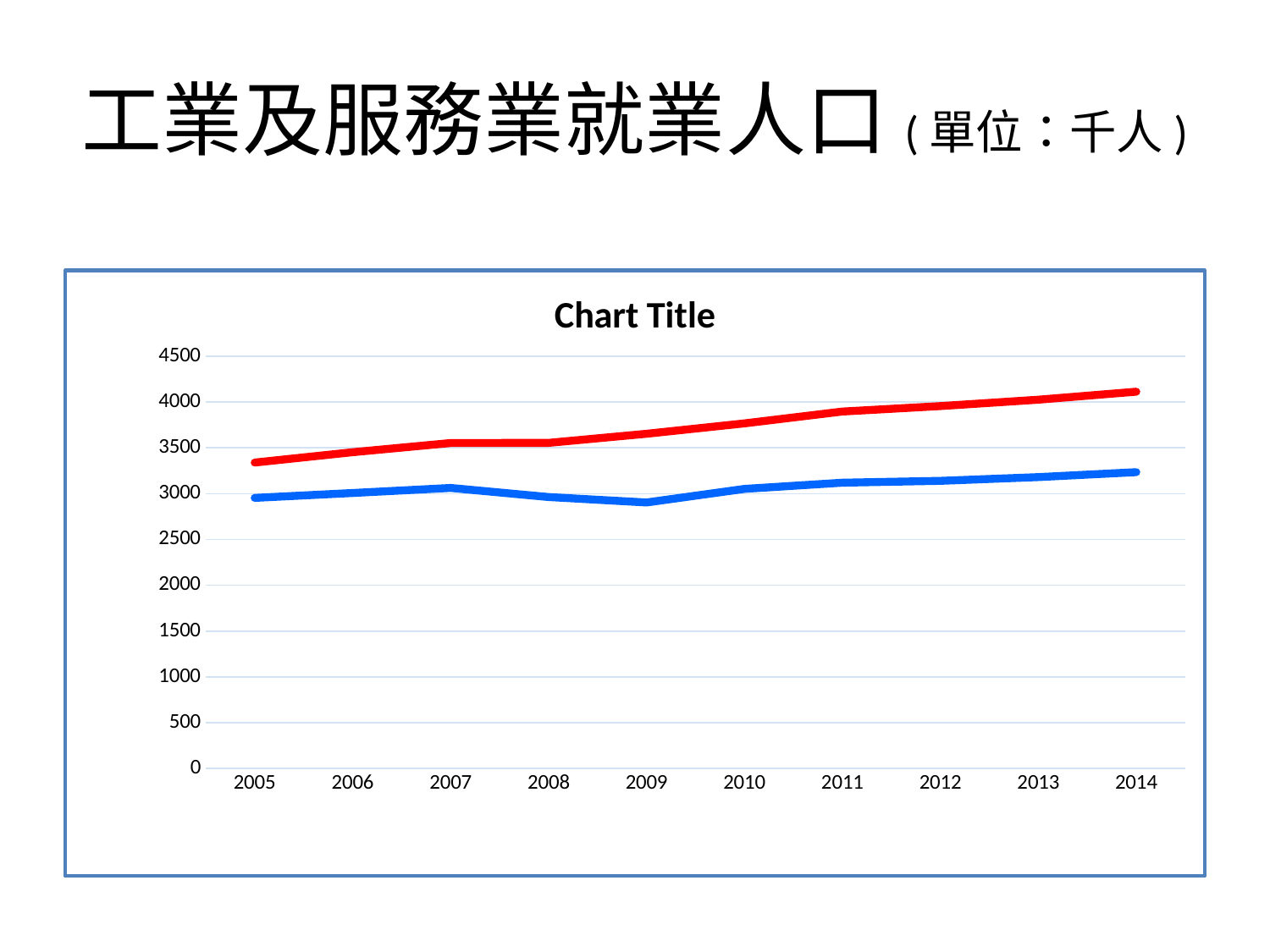
Is the value of the red line in 2005 greater or less than 3000? greater Is the value of the red line in 2014 greater or less than 4000? greater Does the red line generally rise or fall from 2005 to 2014? rise In which year does the blue line reach its lowest value? 2009 Which line is higher in 2014, the red line or the blue line? the red line What kind of chart is shown on the slide? line chart What are the first and last years shown on the x axis? 2005 and 2014 What is the title printed above the chart? Chart Title Is the value of the blue line in 2009 greater or less than 3000? less How many lines are plotted on the chart? 2 How many years are shown on the x axis of the chart? 10